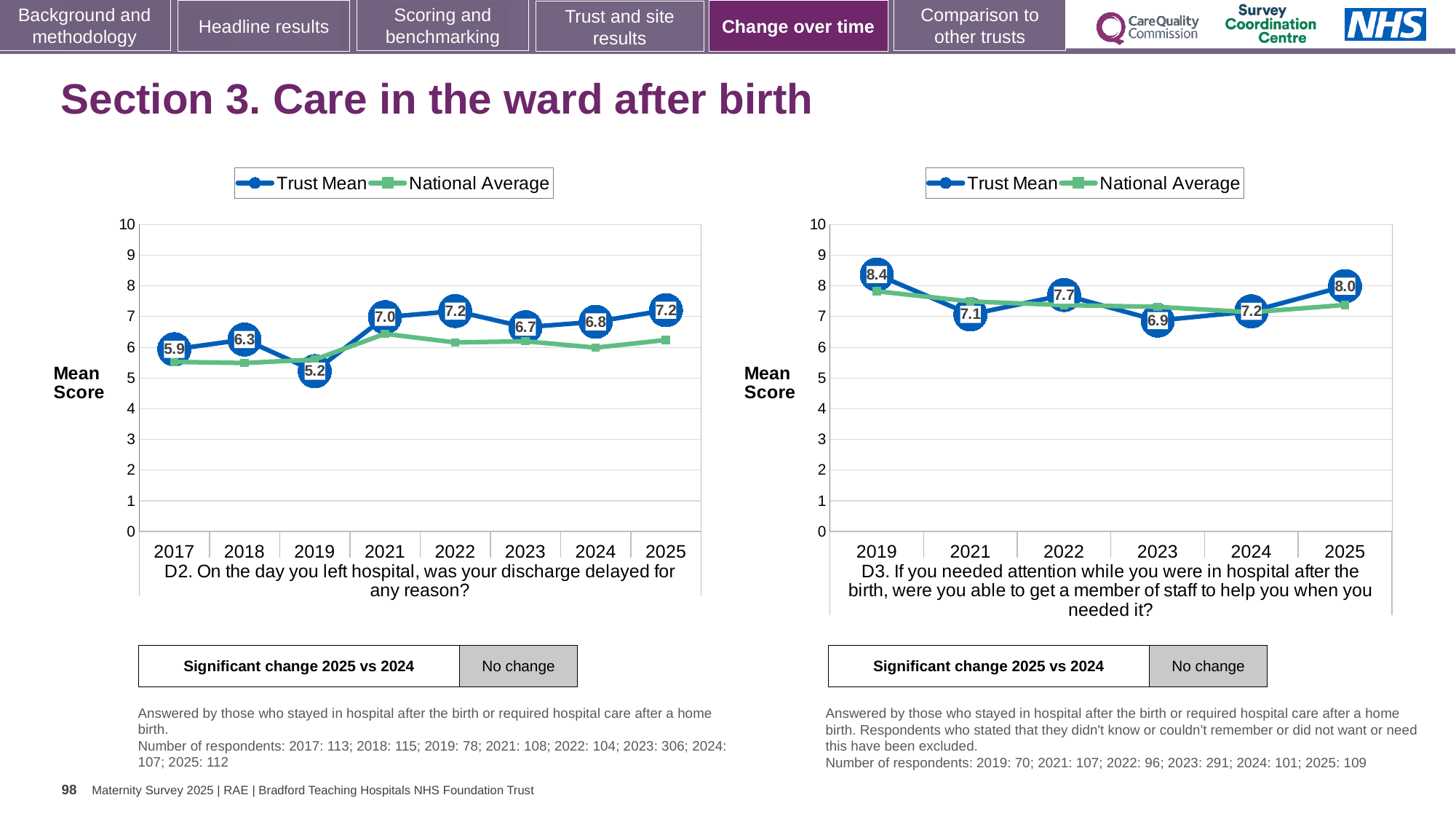
In the D3 chart (right), which year has the highest Trust Mean score? 2019 In the D2 chart (left), how many years are plotted on the x axis? 8 In the D3 chart (right), which year has the lowest Trust Mean score? 2023 What type of chart is the D3 chart (right)? Line chart In the D2 chart (left), what is the Trust Mean score for 2025? 7.2 In the D2 chart (left), what is the difference between the Trust Mean scores for 2021 and 2019? 1.8 In the D2 chart (left), is the National Average value for 2025 greater or less than 7? less In the D2 chart (left), what is the Trust Mean score for 2019? 5.2 In the D2 chart (left), which year has the lowest Trust Mean score? 2019 In the D3 chart (right), what is the Trust Mean score for 2019? 8.4 In the D3 chart (right), is the Trust Mean score for 2025 larger or smaller than the score for 2024? larger In the D3 chart (right), how many series does the legend list? 2